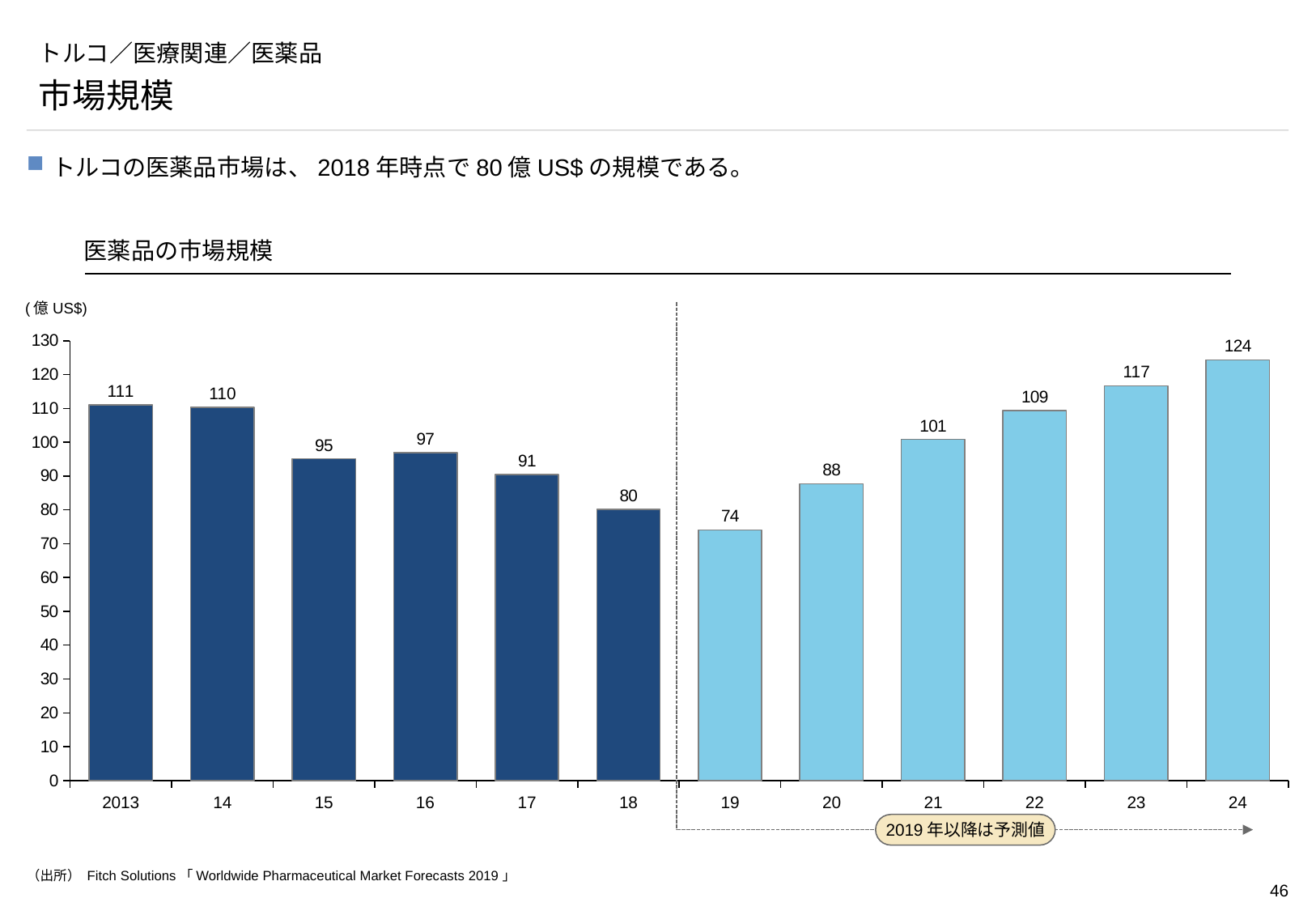
What is the difference between the values for 2013 and 2018? 31 What is the market size value shown for 2018? 80 Which year has the lowest value in the chart? 19 Which year has the highest value in the chart? 24 Do the values rise or fall from 19 to 24? rise What is the value shown for 2024? 124 What is the value shown for 2013? 111 How many years (bars) are shown in the chart? 12 What is the difference between the values for 19 and 24? 50 Which is larger, the value for 15 or the value for 16? 16 What kind of chart is shown on the slide? bar chart What unit is shown for the vertical axis of the chart? 億 US$